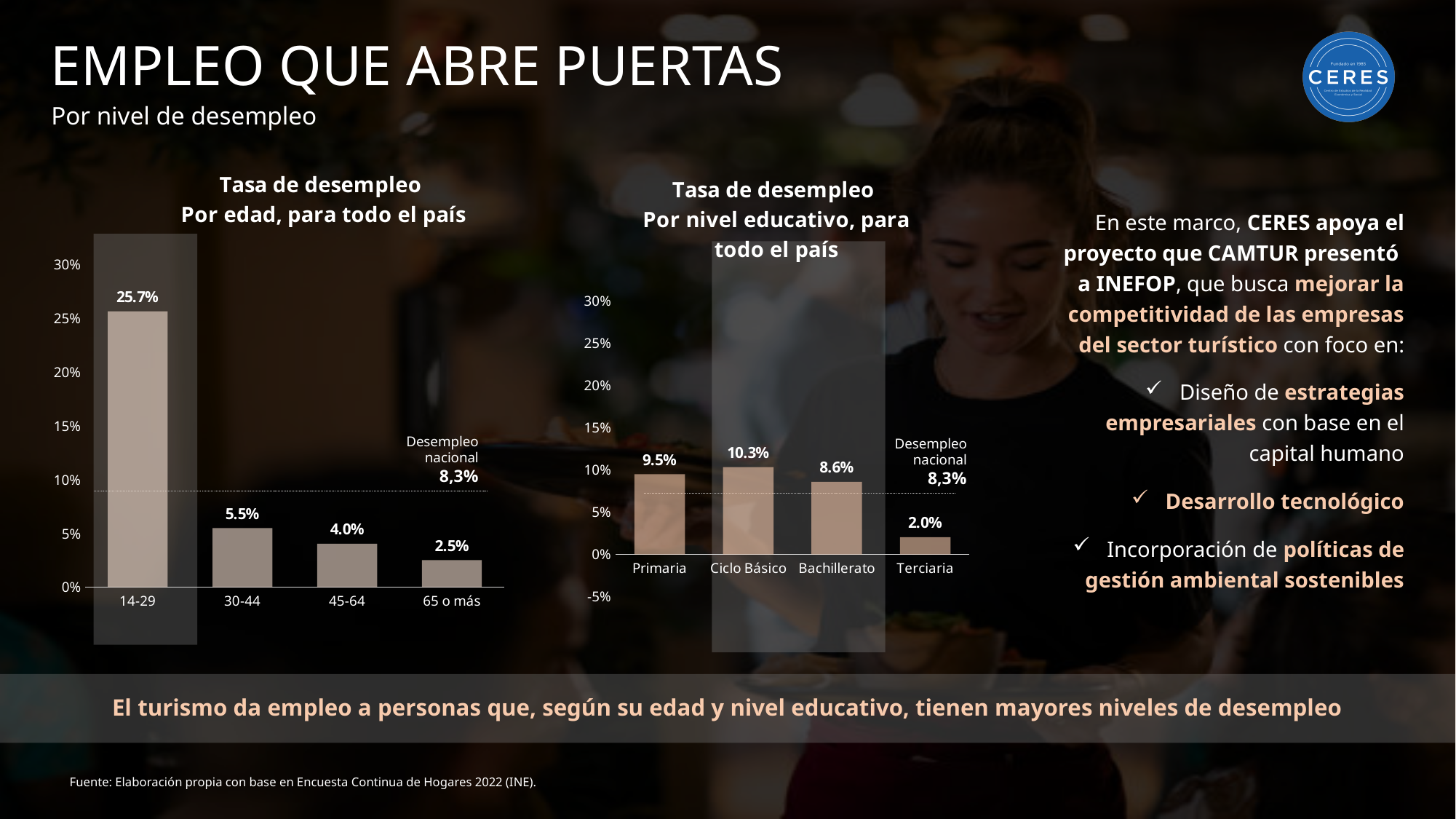
In the chart 'Tasa de desempleo Por edad, para todo el país', which age group has the lowest unemployment rate? 65 o más In the chart 'Tasa de desempleo Por edad, para todo el país', what is the value for the 30-44 age group? 5.5% In the chart 'Tasa de desempleo Por edad, para todo el país', do the values rise or fall as age increases along the x axis? fall In the chart 'Tasa de desempleo Por nivel educativo, para todo el país', what is the value for Ciclo Básico? 10.3% In the chart 'Tasa de desempleo Por edad, para todo el país', what is the unemployment rate for the 14-29 age group? 25.7% In the chart 'Tasa de desempleo Por nivel educativo, para todo el país', which education level has the highest unemployment rate? Ciclo Básico In the chart 'Tasa de desempleo Por edad, para todo el país', how many age groups are shown? 4 In the chart 'Tasa de desempleo Por nivel educativo, para todo el país', which is larger, the value for Primaria or for Bachillerato? Primaria What national unemployment rate ('Desempleo nacional') is marked by the reference line on both charts? 8,3% In the chart 'Tasa de desempleo Por edad, para todo el país', what is the difference between the values for 14-29 and 30-44? 20.2% In the chart 'Tasa de desempleo Por nivel educativo, para todo el país', what is the difference between the values for Bachillerato and Terciaria? 6.6% In the chart 'Tasa de desempleo Por nivel educativo, para todo el país', what is the value for Terciaria? 2.0%